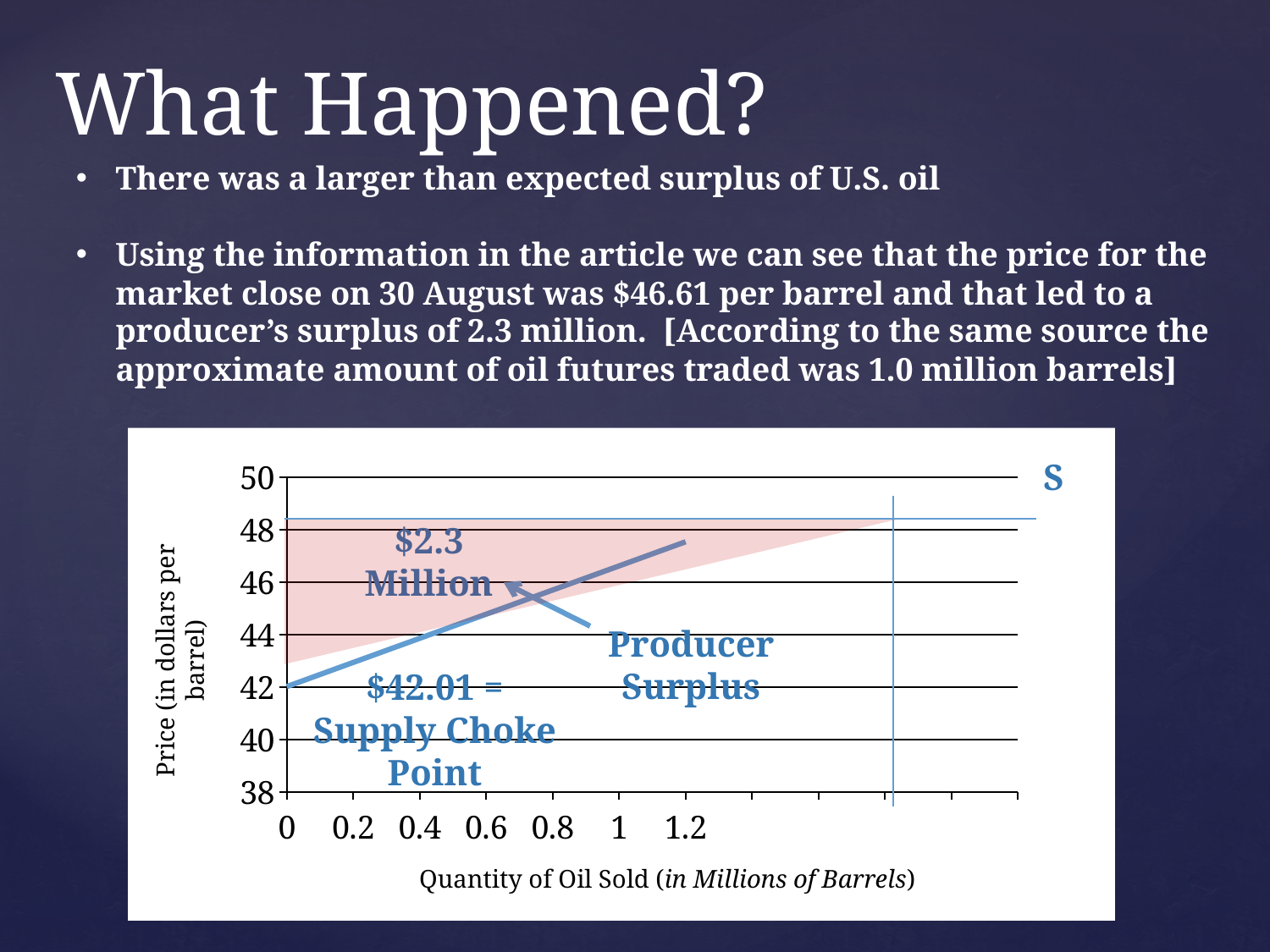
What is the highest value shown on the y axis? 50 According to the chart annotation, what price is labelled as the supply choke point? $42.01 What letter labels the supply curve on the chart? S Is the price on the supply line at a quantity of 0 greater or less than 44? less What is the largest quantity labelled on the x axis? 1.2 Does the supply line rise or fall as quantity increases along the x axis? rise What is the lowest value shown on the y axis? 38 According to the chart annotation, what is the value of the producer surplus? $2.3 Million What is the title of the x axis? Quantity of Oil Sold (in Millions of Barrels) What kind of chart is shown on the slide? line chart Is the price on the supply line at a quantity of 1.2 greater or less than 46? greater